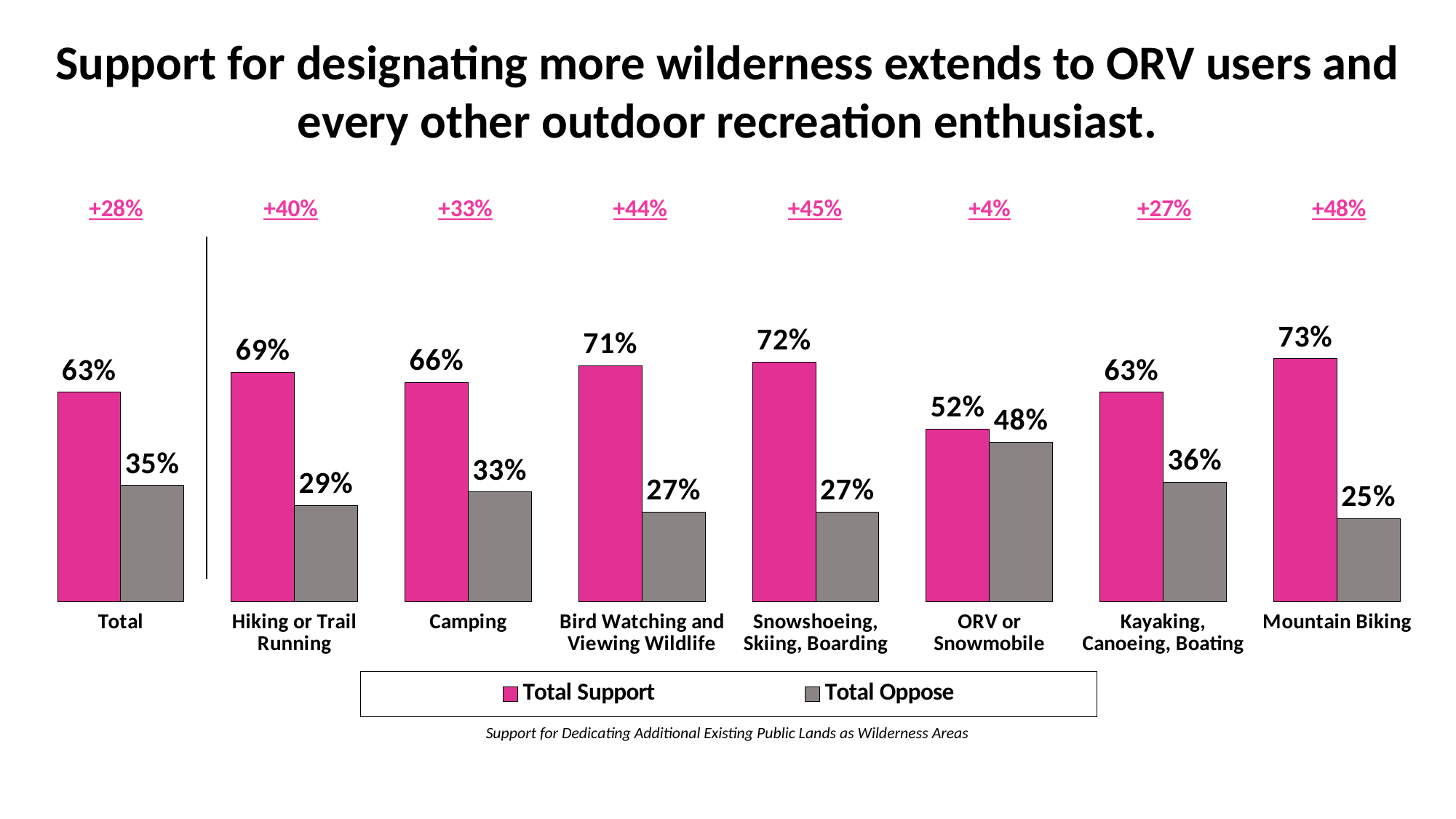
Which category has the lowest Total Oppose value? Mountain Biking Which category has the highest Total Support value? Mountain Biking What is the Total Support value for Camping? 66% What is the Total Support value for Mountain Biking? 73% What is the difference between Total Support and Total Oppose for Hiking or Trail Running? 40% Which category has the lowest Total Support value? ORV or Snowmobile What is the Total Oppose value for ORV or Snowmobile? 48% What colour are the Total Support bars? Pink How many series does the legend list? 2 What kind of chart is shown on the slide? Bar chart Which is larger for Kayaking, Canoeing, Boating: Total Support or Total Oppose? Total Support How many categories are shown on the x axis? 8